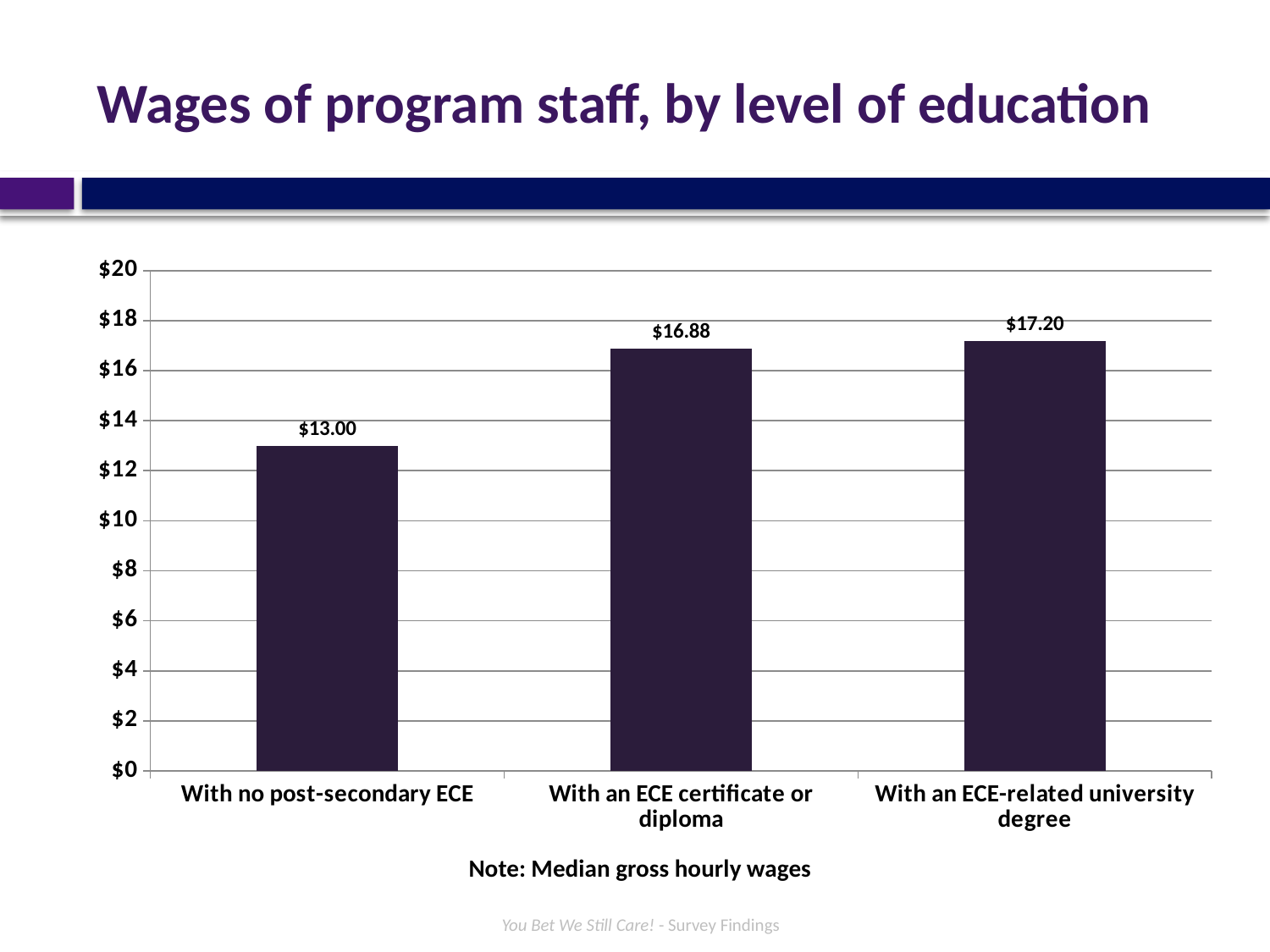
How many levels of education are shown on the chart? 3 What is the difference in median hourly wage between staff with an ECE certificate or diploma and staff with no post-secondary ECE? $3.88 Which level of education has the highest median gross hourly wage? With an ECE-related university degree What is the median gross hourly wage for program staff with an ECE certificate or diploma? $16.88 What is the median gross hourly wage for program staff with no post-secondary ECE? $13.00 What is the difference in median hourly wage between staff with an ECE-related university degree and staff with no post-secondary ECE? $4.20 What kind of chart is shown on the slide? Bar chart Which is larger: the wage for staff with an ECE certificate or diploma, or the wage for staff with no post-secondary ECE? With an ECE certificate or diploma Is the value for staff with no post-secondary ECE greater or less than $14? less What is the median gross hourly wage for program staff with an ECE-related university degree? $17.20 Do the wages rise or fall as the level of education increases from left to right? Rise Which level of education has the lowest median gross hourly wage? With no post-secondary ECE